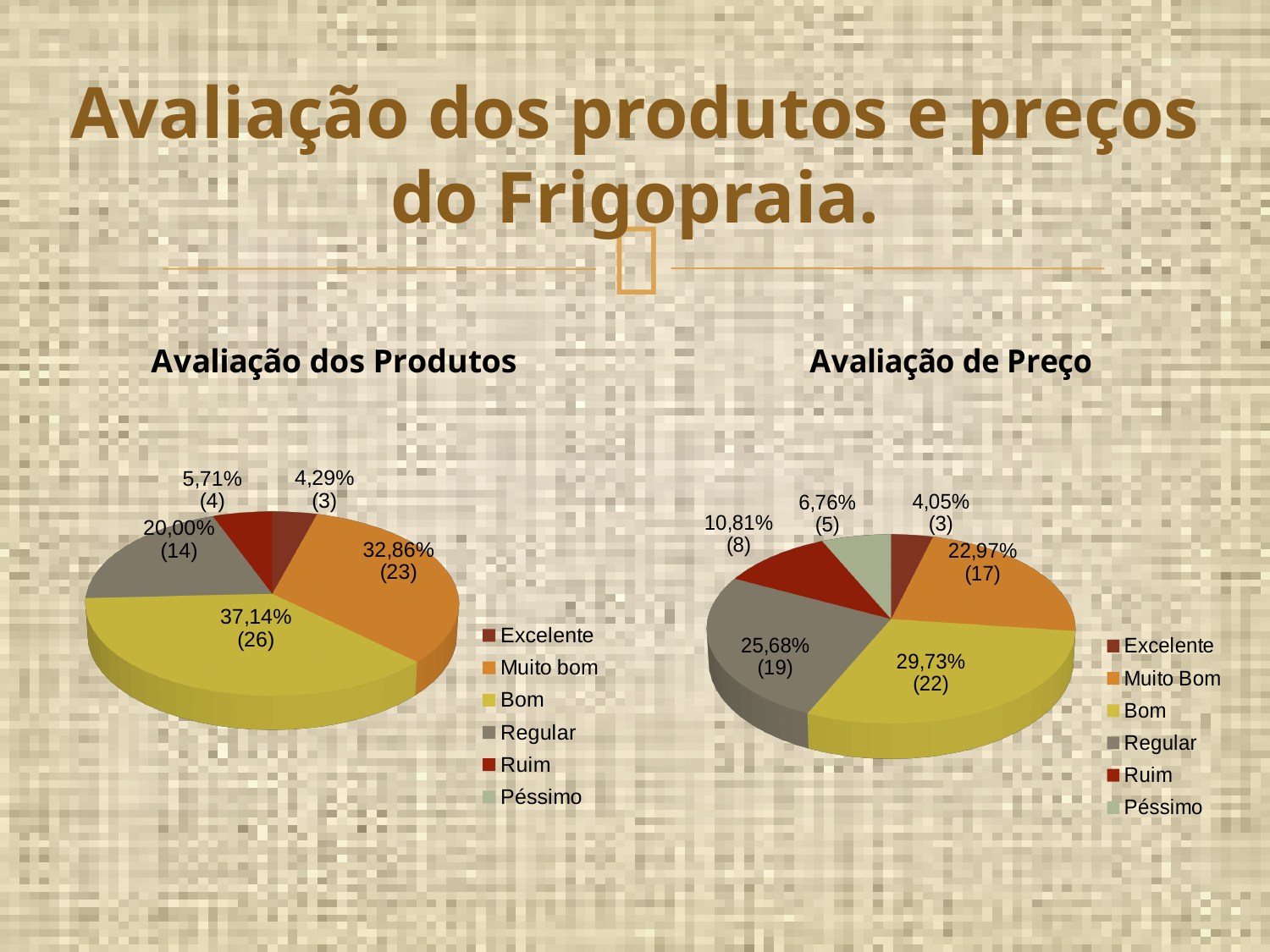
How many entries does the legend of the 'Avaliação de Preço' chart list? 6 In the 'Avaliação dos Produtos' chart, which category has the largest share? Bom In the 'Avaliação dos Produtos' chart, what is the difference in responses between Bom (26) and Regular (14)? 12 In the 'Avaliação dos Produtos' chart, what percentage is shown for Bom? 37,14% In the 'Avaliação de Preço' chart, what colour represents Bom? Yellow In the 'Avaliação de Preço' chart, which category has the smallest share? Excelente In the 'Avaliação de Preço' chart, which is larger: Muito Bom or Regular? Regular What type of chart is used for 'Avaliação dos Produtos'? Pie chart In the 'Avaliação dos Produtos' chart, how many responses are shown for Muito bom? 23 In the 'Avaliação de Preço' chart, what percentage is shown for Regular? 25,68% In the 'Avaliação de Preço' chart, what is the difference in percentage points between Bom and Muito Bom? 6,76 In the 'Avaliação de Preço' chart, how many responses are shown for Ruim? 8